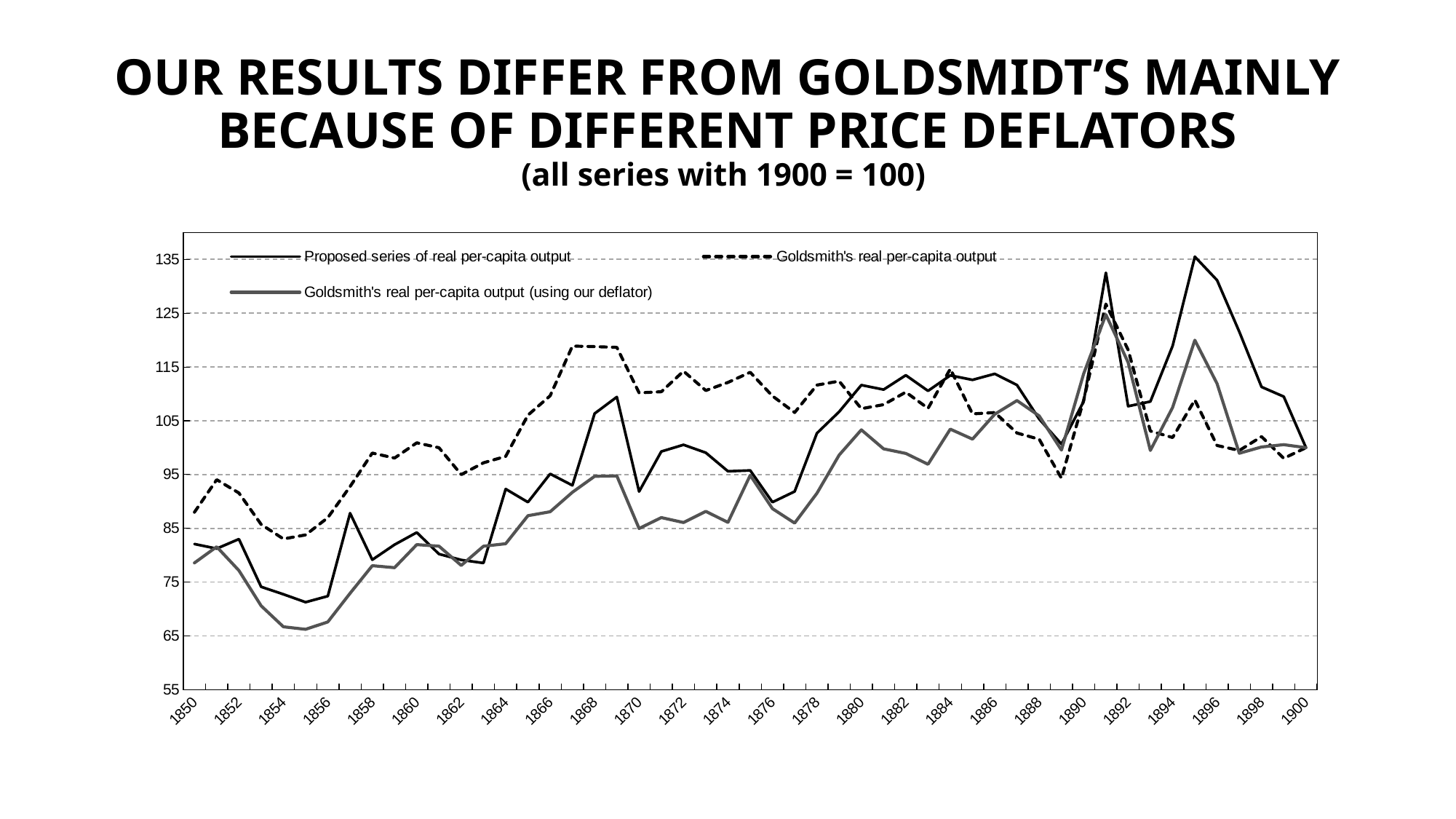
In 1868, which is larger: Goldsmith's real per-capita output or the Proposed series of real per-capita output? Goldsmith's real per-capita output What is the base year in which all series equal 100? 1900 Overall, does the Proposed series of real per-capita output rise or fall from 1850 to 1900? rise Which series is drawn with a dashed line? Goldsmith's real per-capita output Is the value of Goldsmith's real per-capita output (using our deflator) in 1854 greater or less than 75? less Is the value of the Proposed series of real per-capita output in 1895 greater or less than 125? greater What kind of chart is shown on the slide? line chart In which year does the Proposed series of real per-capita output reach its peak? 1895 Is the value of Goldsmith's real per-capita output in 1868 greater or less than 115? greater Which series reaches the highest value anywhere on the chart? Proposed series of real per-capita output How many series does the legend list? 3 What is the value of the Proposed series of real per-capita output in 1900? 100